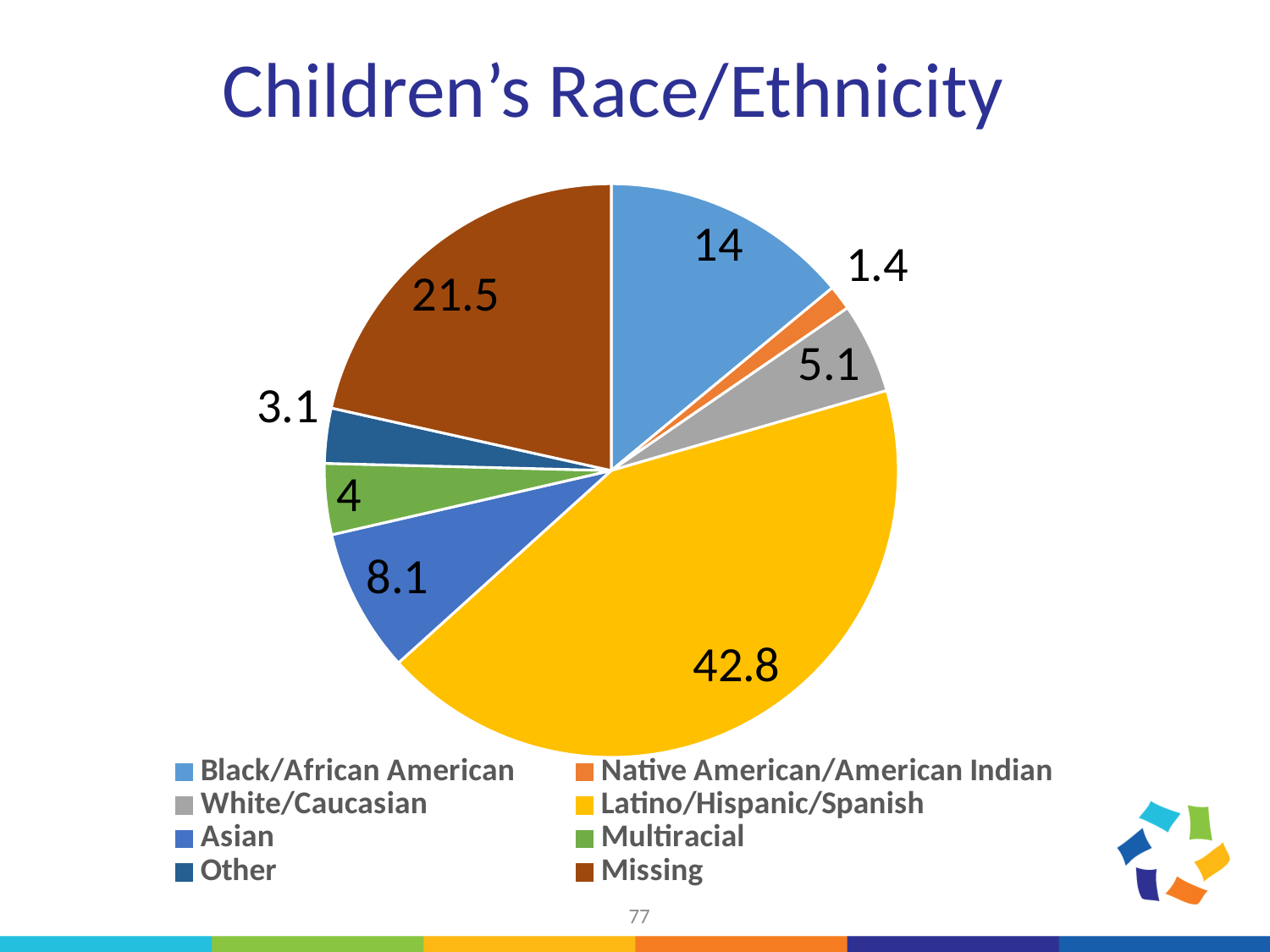
Which is larger, the value for White/Caucasian or the value for Multiracial? White/Caucasian What is the value for Missing? 21.5 What type of chart is shown on the slide? Pie chart What is the value for Black/African American? 14 Which category has the largest slice? Latino/Hispanic/Spanish What is the title of the chart? Children's Race/Ethnicity Which category has the smallest slice? Native American/American Indian What is the value for Native American/American Indian? 1.4 How many categories does the pie chart have? 8 What is the value for Asian? 8.1 What is the difference between the values for Missing and Black/African American? 7.5 What is the value for Latino/Hispanic/Spanish? 42.8